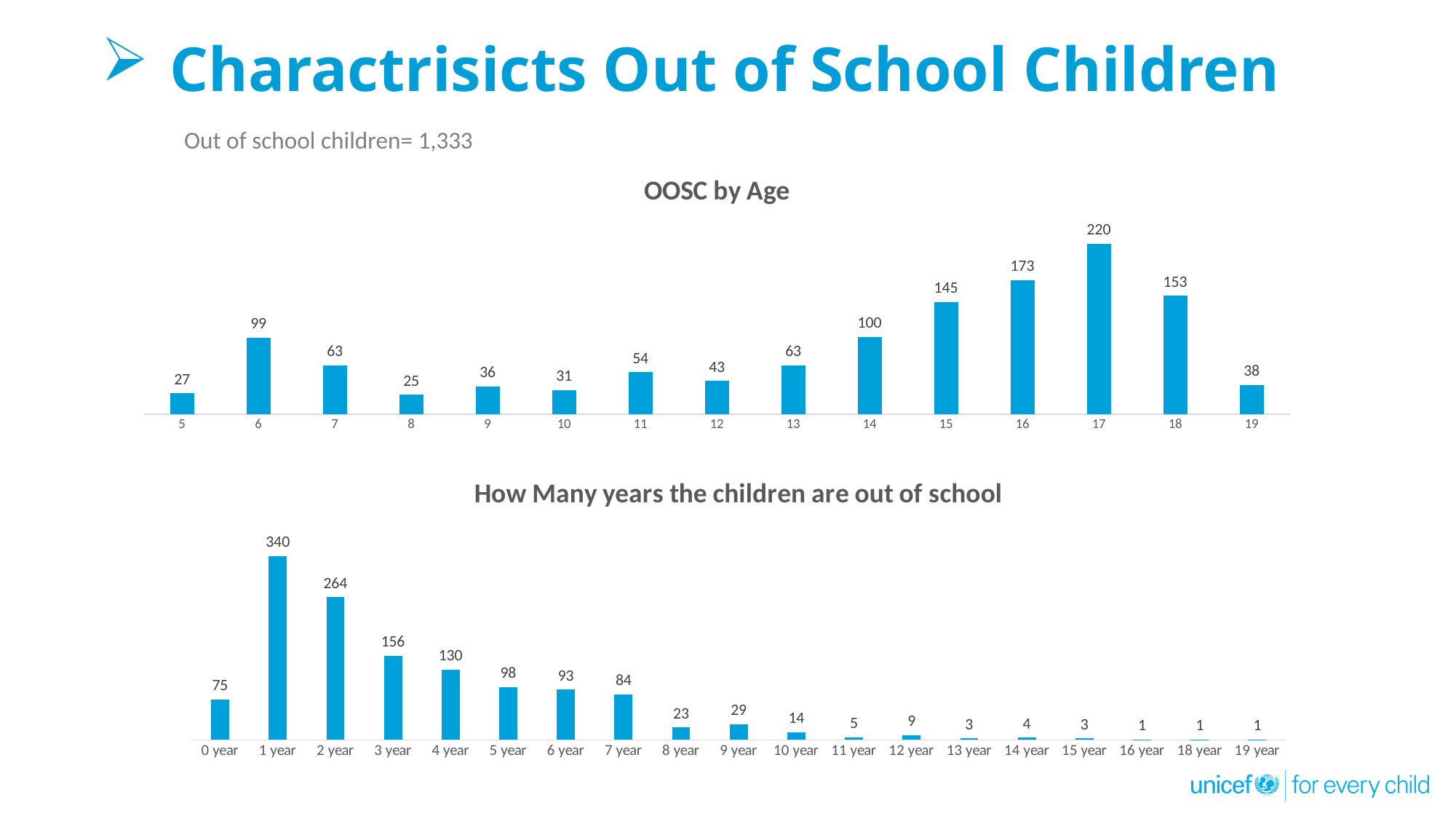
In the 'How Many years the children are out of school' chart, which category has the highest value? 1 year What is the title of the top chart on the slide? OOSC by Age In the 'OOSC by Age' chart, what is the difference between the values for age 16 and age 15? 28 In the 'OOSC by Age' chart, which is larger, the value for age 6 or the value for age 14? 14 In the 'OOSC by Age' chart, which age has the lowest value? 8 In the 'OOSC by Age' chart, what is the value for age 11? 54 What type of chart is the 'How Many years the children are out of school' chart? Bar chart In the 'How Many years the children are out of school' chart, what is the difference between the values for 1 year and 2 year? 76 In the 'How Many years the children are out of school' chart, how many categories are shown on the x axis? 19 In the 'OOSC by Age' chart, what is the value for age 17? 220 In the 'How Many years the children are out of school' chart, what is the value for 3 year? 156 In the 'OOSC by Age' chart, how many age categories are shown? 15